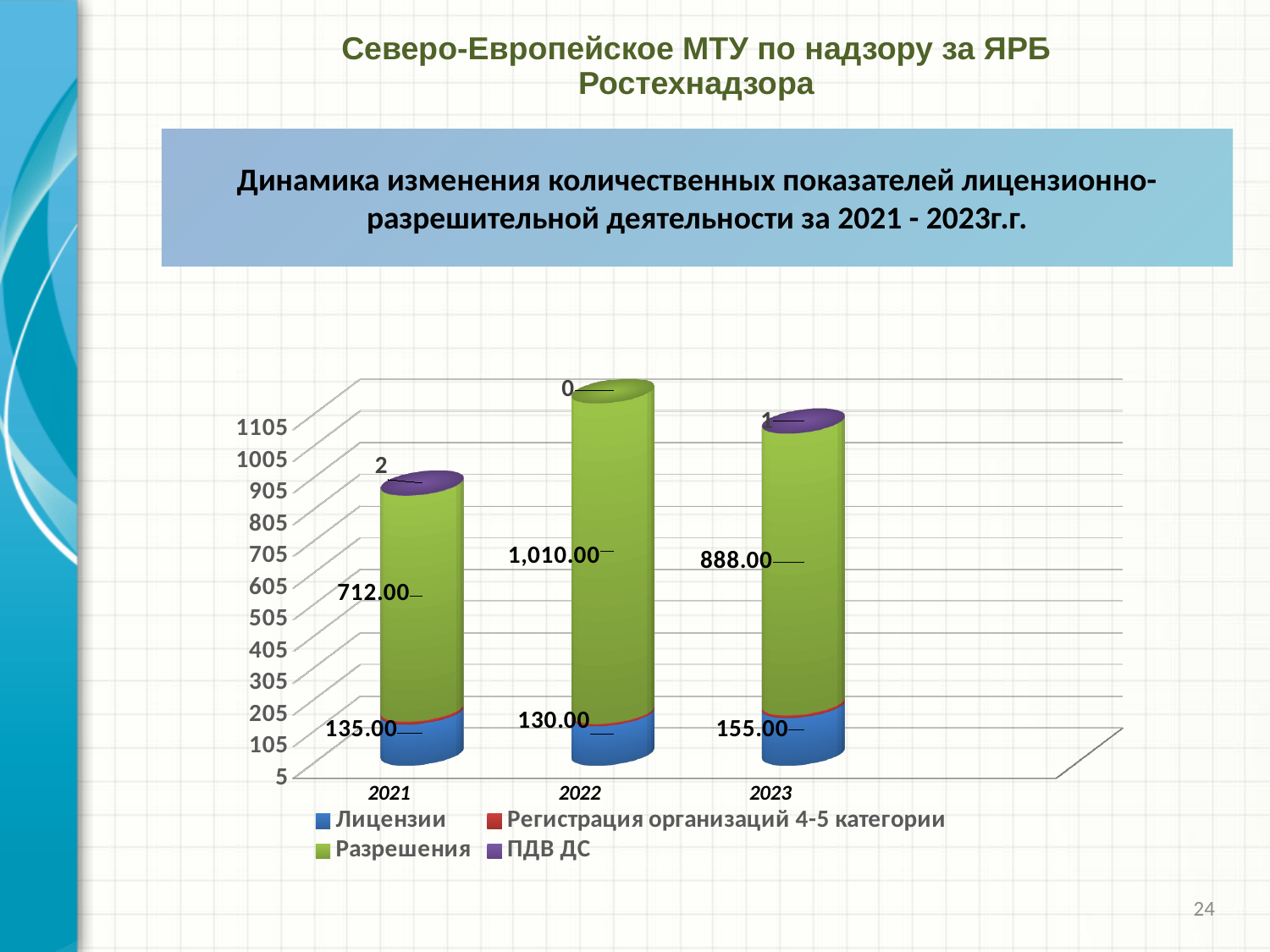
How many series does the legend list? 4 Which year has the larger Лицензии value, 2021 or 2023? 2023 What is the difference between the Разрешения values for 2022 and 2023? 122.00 What kind of chart is shown on the slide? Stacked bar chart What is the value of Разрешения for 2022? 1,010.00 By how much did the Лицензии value in 2023 exceed the value in 2021? 20.00 How many years are shown on the x axis of the chart? 3 In which year is the value of Лицензии the lowest? 2022 What is the value of Разрешения for 2021? 712.00 What is the value of Лицензии for 2022? 130.00 What is the value of ПДВ ДС for 2021? 2 In which year is the value of Разрешения the highest? 2022